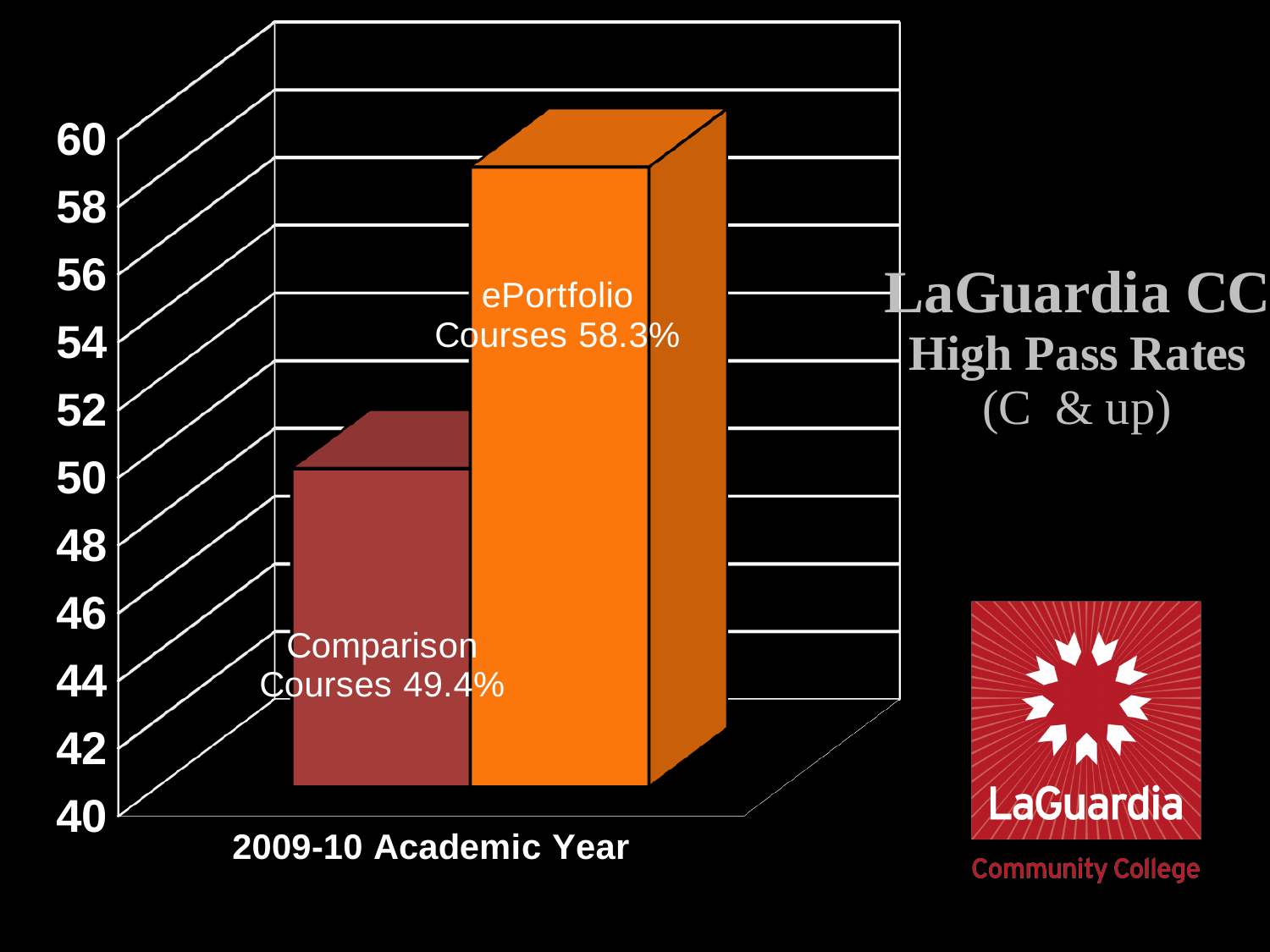
What is the title of the chart? LaGuardia CC High Pass Rates (C & up) What kind of chart is shown on the slide? Bar chart How many bars are plotted on the chart? 2 What is the high pass rate for ePortfolio Courses? 58.3% Is the value for ePortfolio Courses greater or less than 56? greater What is the difference between the ePortfolio Courses pass rate and the Comparison Courses pass rate? 8.9% Which bar shows the lowest value? Comparison Courses Which group has the higher pass rate, ePortfolio Courses or Comparison Courses? ePortfolio Courses What is the lowest value shown on the vertical axis? 40 What is the high pass rate for Comparison Courses? 49.4% What academic year does the chart cover, according to the x-axis label? 2009-10 Academic Year Is the value for Comparison Courses greater or less than 50? less